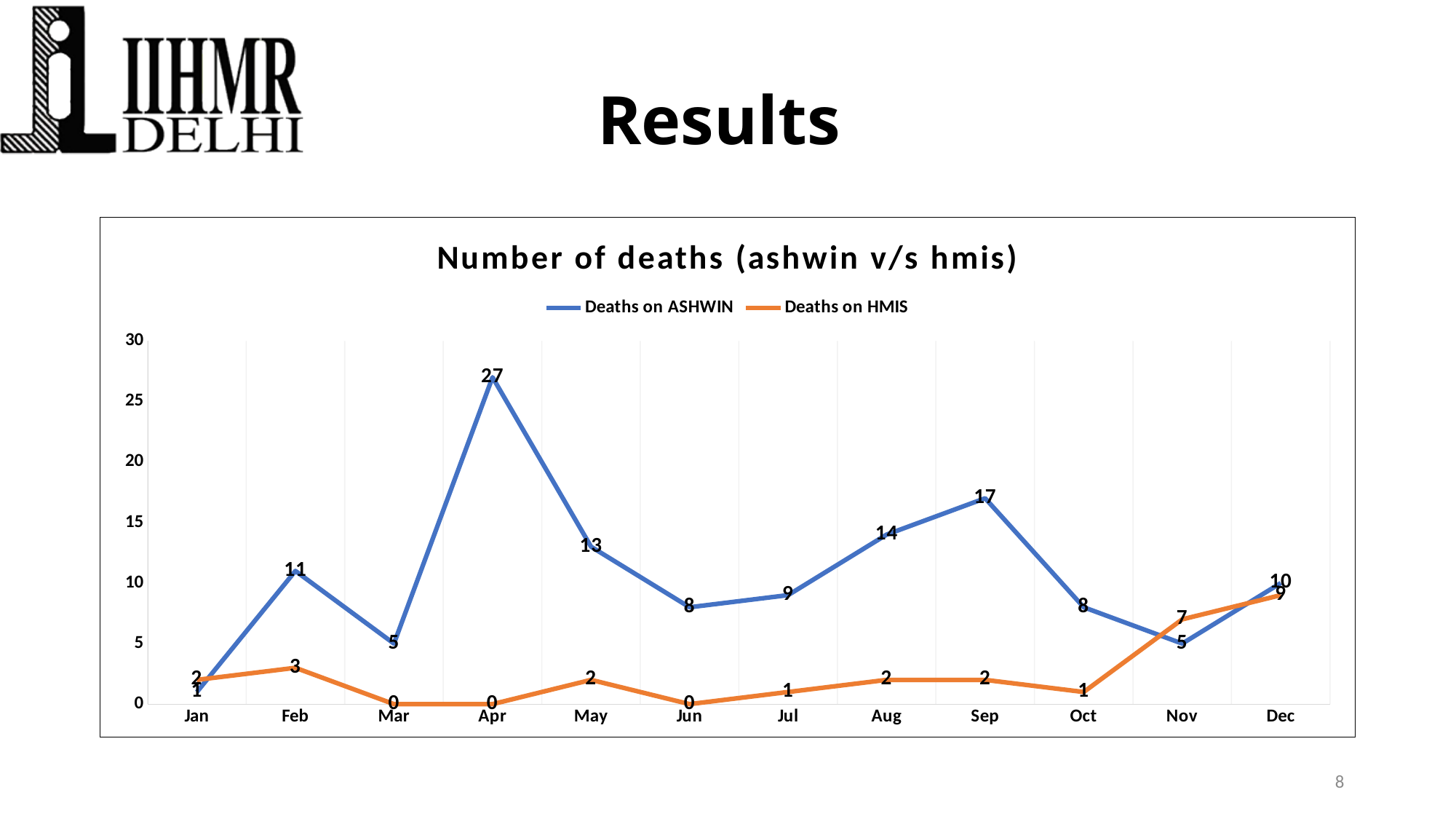
In which month is Deaths on ASHWIN highest? Apr Which is larger in Nov, Deaths on ASHWIN or Deaths on HMIS? Deaths on HMIS How many months are plotted along the x axis? 12 What is the value for Deaths on ASHWIN in Apr? 27 What is the value for Deaths on HMIS in Nov? 7 What is the value for Deaths on ASHWIN in Sep? 17 What is the difference between Deaths on ASHWIN and Deaths on HMIS in Apr? 27 How many series does the legend list? 2 What is the title of the chart? Number of deaths (ashwin v/s hmis) In which month is Deaths on ASHWIN lowest? Jan What type of chart is shown on the slide? Line chart In which month is Deaths on HMIS highest? Dec